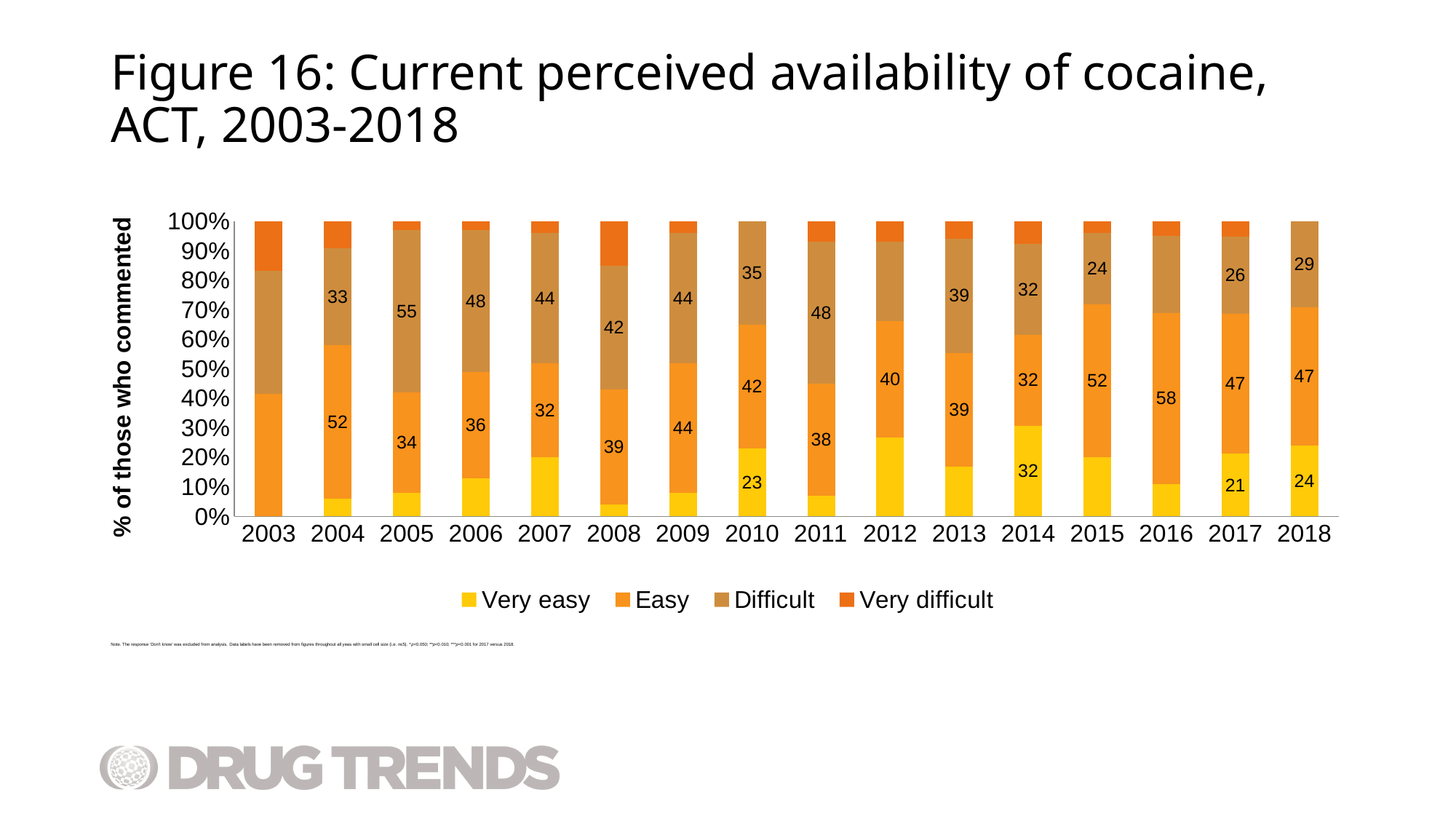
How many years are shown on the x axis? 16 What is the difference between the Easy and Difficult values in 2018? 18 Is the Very difficult segment for 2003 greater or less than 10%? greater How many series does the legend list? 4 What are the four legend entries? Very easy, Easy, Difficult, Very difficult Which year has the highest labelled value for Easy? 2016 What kind of chart is shown on the slide? Stacked bar chart What is the value for Easy in 2016? 58 What is the value for Difficult in 2010? 35 Which is larger: the Difficult value in 2006 or the Difficult value in 2015? 2006 What is the value for Very easy in 2014? 32 What is the value for Difficult in 2005? 55